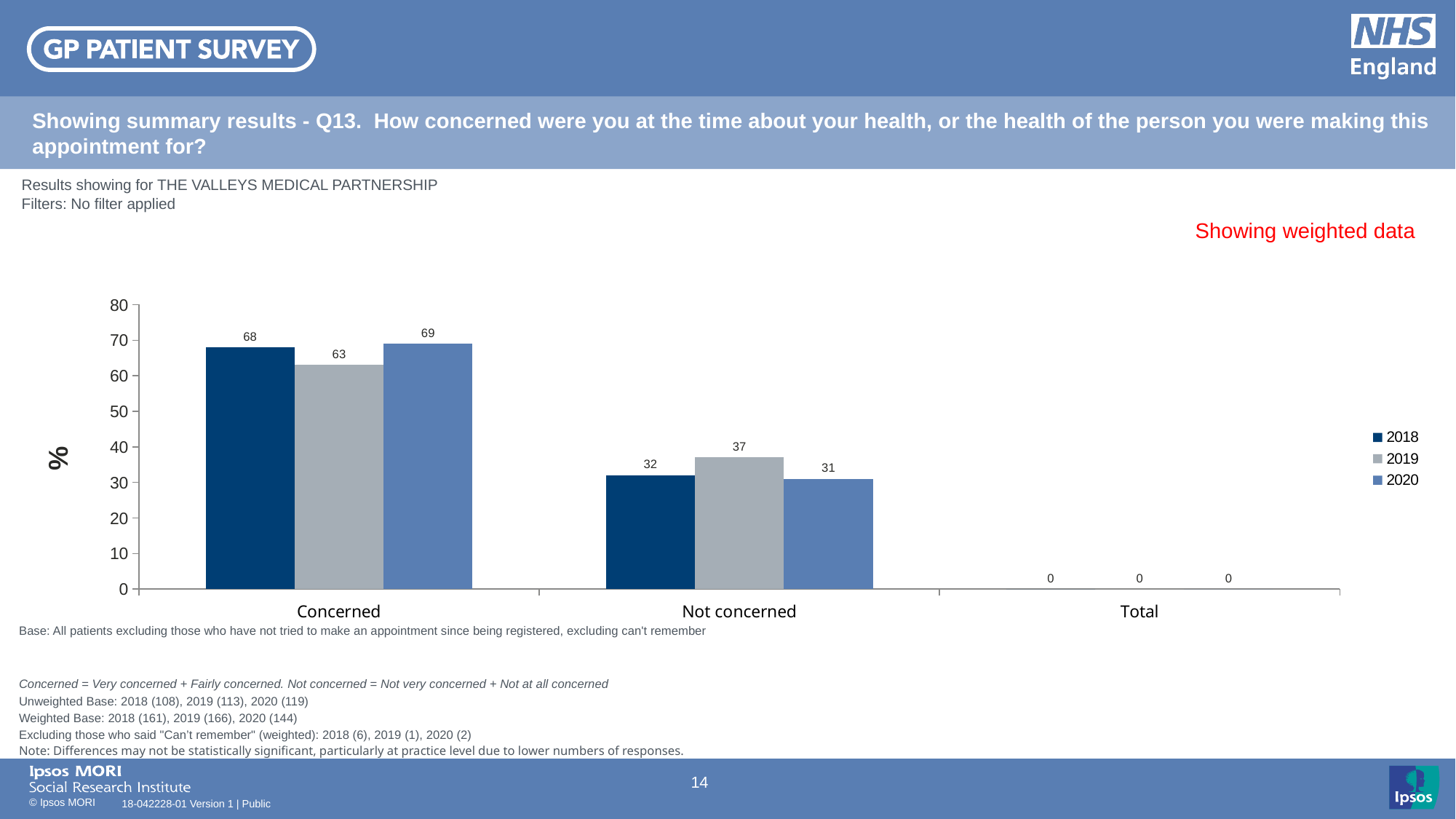
How many categories are shown on the x axis? 3 Which is larger: the 2019 value for Concerned or the 2019 value for Not concerned? Concerned What is the value for 2020 in the Not concerned category? 31 What is the value for 2018 in the Concerned category? 68 How many series does the legend list? 3 What is the value for 2020 in the Concerned category? 69 Which year has the highest value in the Concerned category? 2020 What is the difference between the 2018 and 2019 values in the Concerned category? 5 What is the value for 2019 in the Not concerned category? 37 What label is shown on the y axis? % What kind of chart is shown on the slide? Bar chart Which year has the lowest value in the Not concerned category? 2020